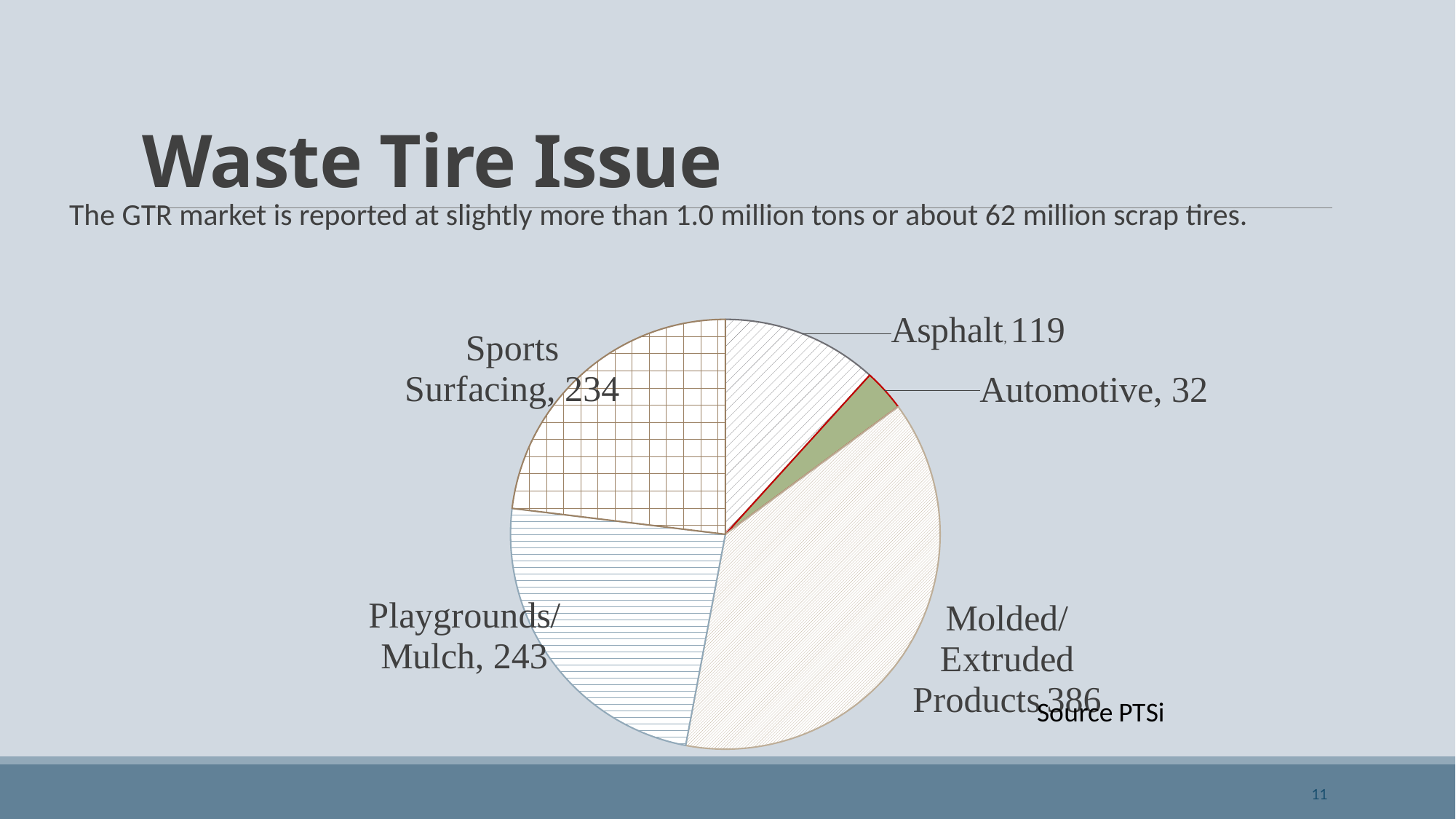
What value is shown for Playgrounds/Mulch in the pie chart? 243 What is the difference between the values for Asphalt and Automotive? 87 Which category has the smallest slice in the pie chart? Automotive What type of chart is shown on the slide? Pie chart What value is shown for Automotive in the pie chart? 32 What value is shown for Asphalt in the pie chart? 119 What value is shown for Sports Surfacing in the pie chart? 234 What value is shown for Molded/Extruded Products in the pie chart? 386 Which category has the largest slice in the pie chart? Molded/Extruded Products What is the difference between the values for Molded/Extruded Products and Asphalt? 267 Which is larger, Playgrounds/Mulch or Sports Surfacing? Playgrounds/Mulch How many slices does the pie chart have? 5